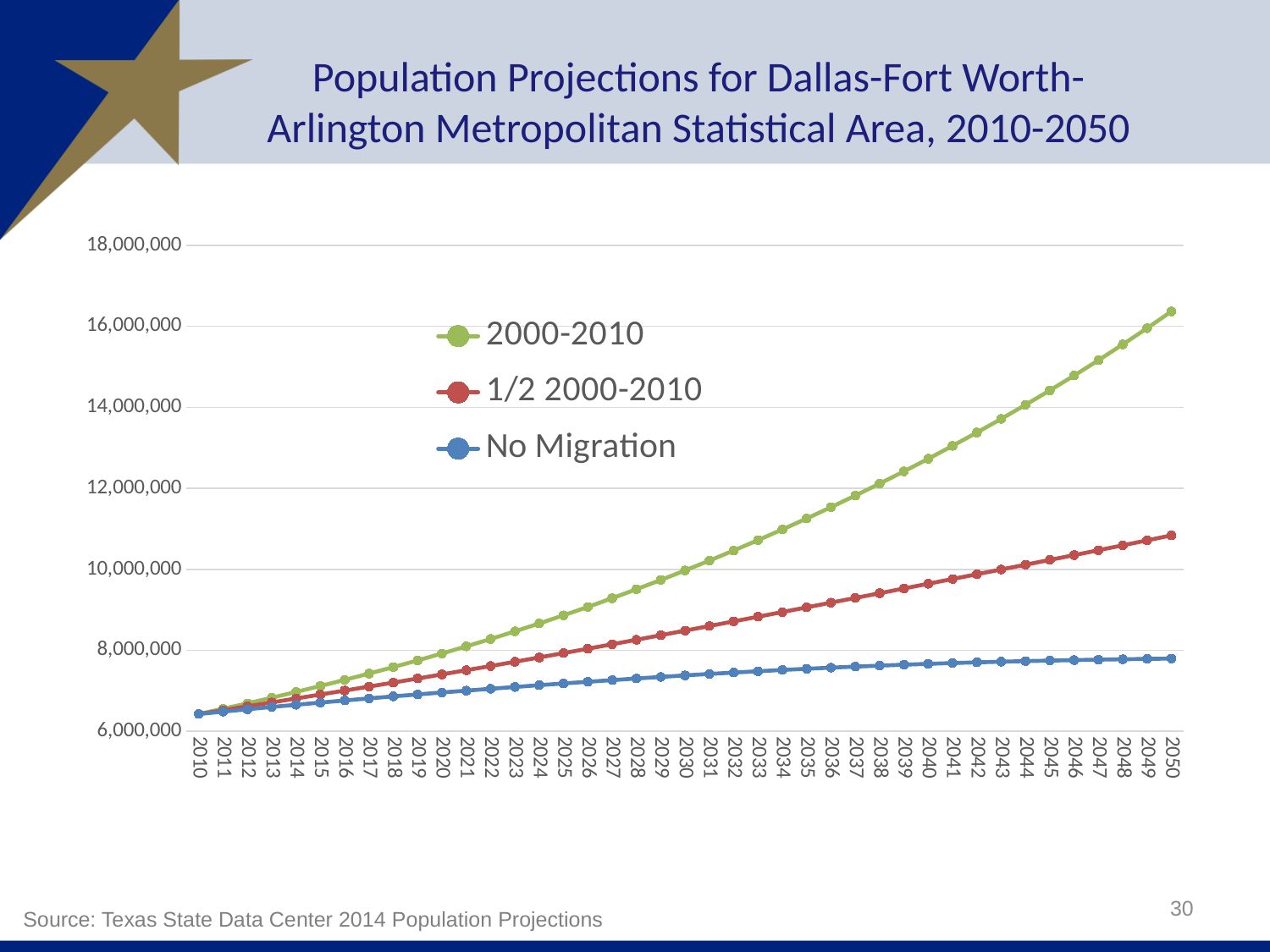
Is the value for the 2000-2010 series in 2050 greater or less than 16,000,000? greater Which series has the lowest value in 2050? No Migration Which is larger in 2040: the 1/2 2000-2010 series or the No Migration series? 1/2 2000-2010 Is the value for the No Migration series in 2050 greater or less than 8,000,000? less Which series has the highest value in 2050? 2000-2010 How many series does the legend list? 3 What is the first year shown on the x axis? 2010 What kind of chart is shown on the slide? line chart Is the value for the 1/2 2000-2010 series in 2050 greater or less than 10,000,000? greater Does the 2000-2010 series rise or fall from 2010 to 2050? rise What colour is the line for the No Migration series? blue